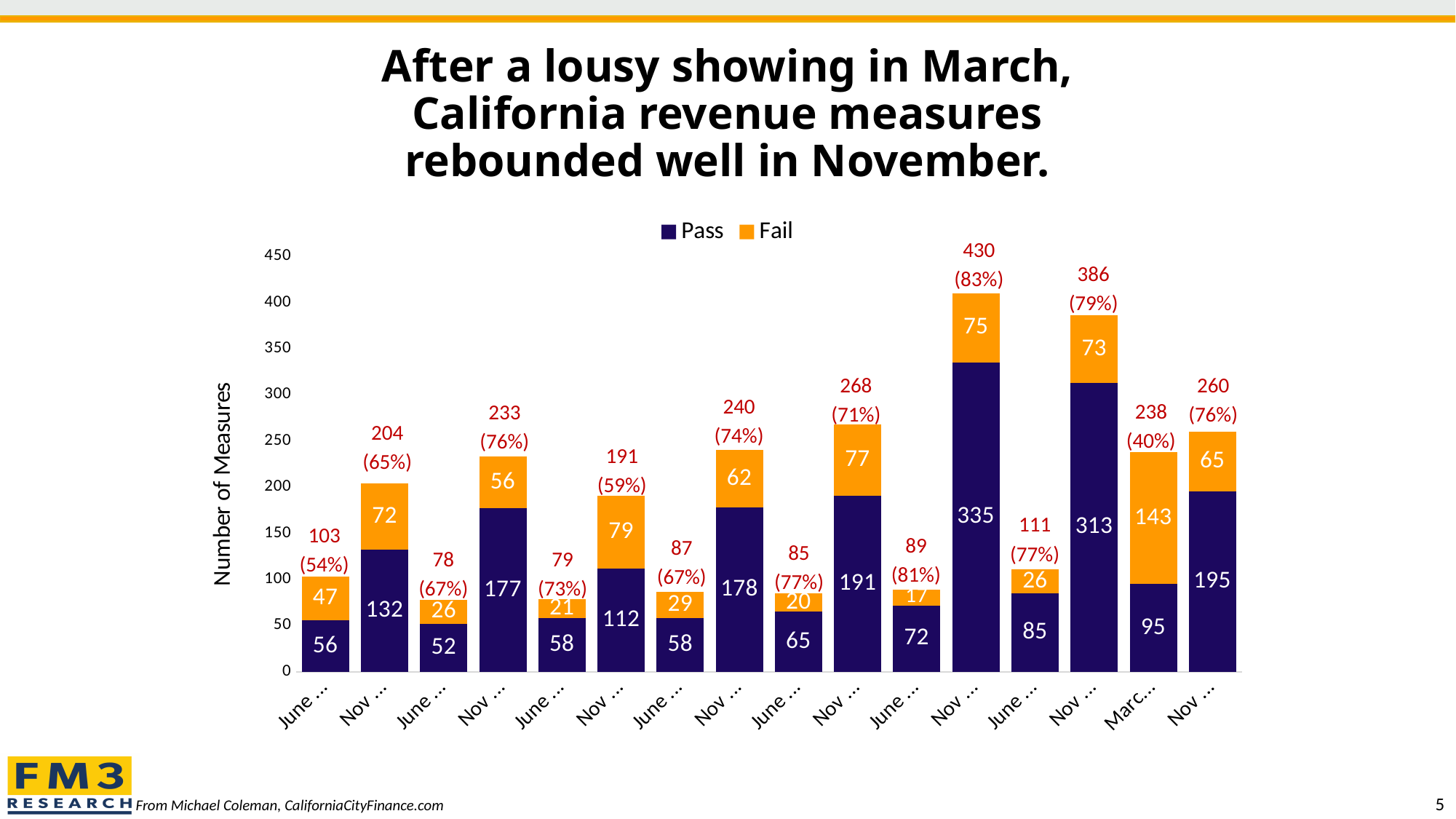
What kind of chart is shown on the slide? Stacked bar chart What percentage is printed above the bar labeled 'Marc…'? (40%) Which bar has the highest total number of measures, and what is that total? The 12th bar (Nov…), 430 What is the Fail value for the bar labeled 'Marc…' (the 15th bar)? 143 How many bars are plotted in the chart? 16 What is the title of the vertical axis? Number of Measures What is the difference between the Pass value of the 12th bar (335) and the Pass value of the 14th bar (313)? 22 What is the lowest total number of measures shown above any bar? 78 What is the Pass value for the last bar on the right? 195 How many series does the legend list? 2 What is the total number of measures for the last bar on the right? 260 In the bar labeled 'Marc…', which is larger, the Pass value or the Fail value? Fail